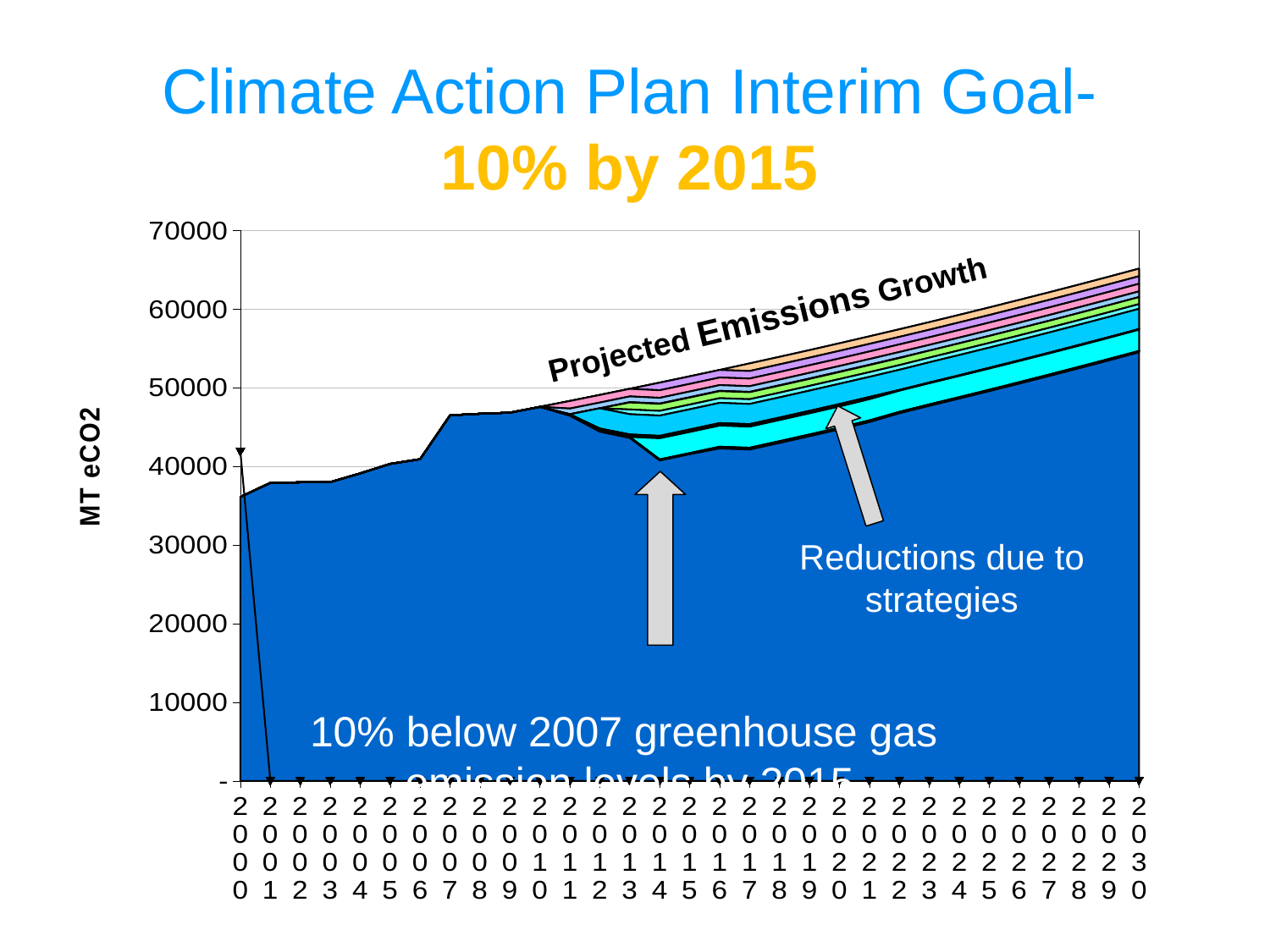
What is the first year shown on the horizontal axis of the chart? 2000 Does the top of the stacked area rise or fall between 2010 and 2030? rise What kind of chart is shown on the slide? Area chart Is the value of the dark blue area in 2007 greater or less than 50000 MT eCO2? less Is the value of the dark blue area in 2007 greater or less than 40000 MT eCO2? greater What does the text annotation along the top of the stacked area say? Projected Emissions Growth Is the top of the stacked area in 2030 greater or less than 60000 MT eCO2? greater What is the last year shown on the horizontal axis of the chart? 2030 What is the label on the vertical axis of the chart? MT eCO2 What is the highest value shown on the vertical axis of the chart? 70000 How many years are shown along the horizontal axis of the chart? 31